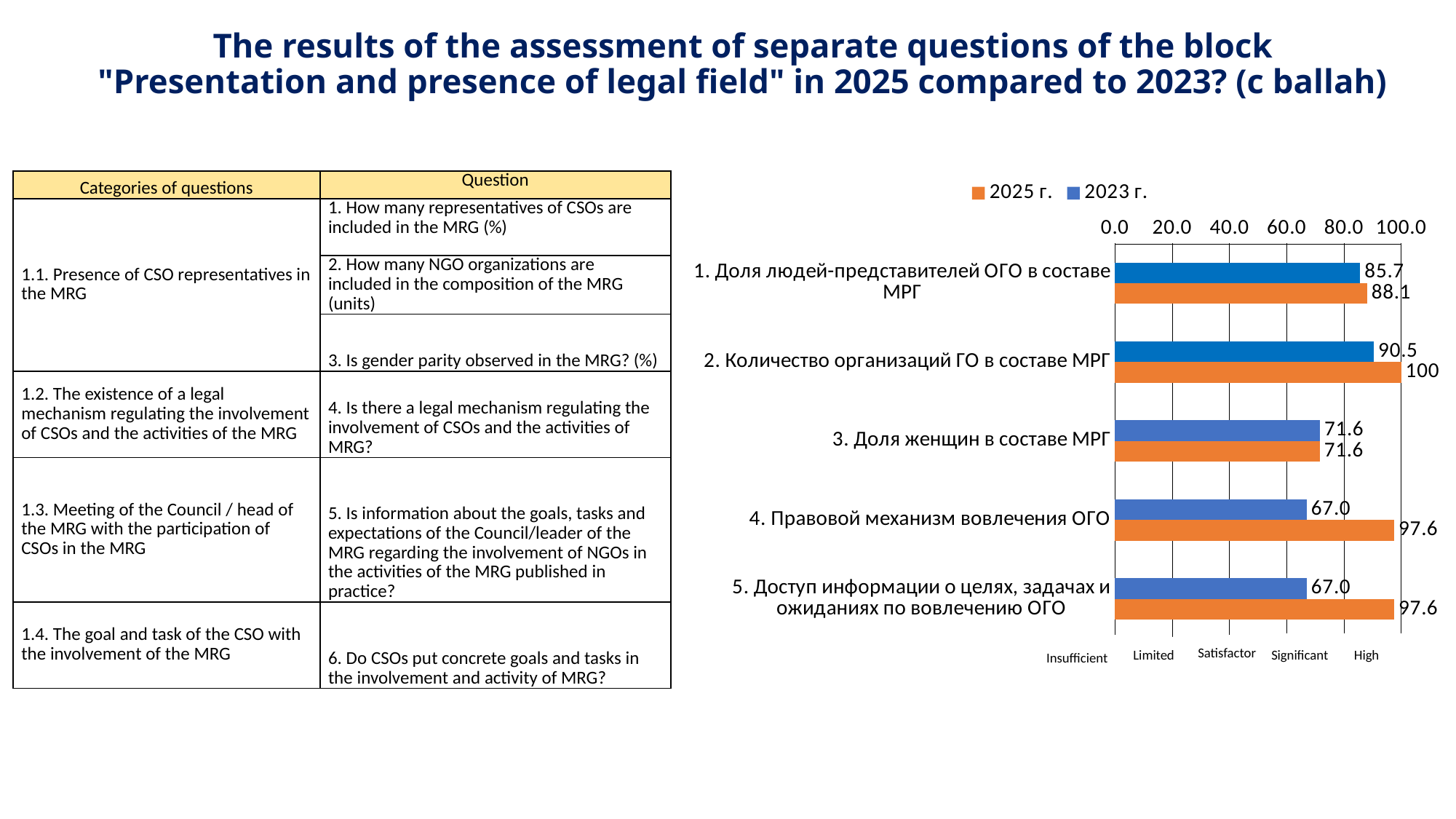
Which category has the highest 2025 г. value? 2. Количество организаций ГО в составе МРГ How many series does the chart legend list? 2 Which is larger for "1. Доля людей-представителей ОГО в составе МРГ": the 2025 г. value or the 2023 г. value? 2025 г. What is the 2023 г. value for "3. Доля женщин в составе МРГ"? 71.6 What type of chart is shown on the slide? bar chart How many categories are plotted in the chart? 5 What is the 2023 г. value for "1. Доля людей-представителей ОГО в составе МРГ"? 85.7 What is the difference between the 2025 г. and 2023 г. values for "4. Правовой механизм вовлечения ОГО"? 30.6 What is the 2025 г. value for "2. Количество организаций ГО в составе МРГ"? 100 What is the 2025 г. value for "4. Правовой механизм вовлечения ОГО"? 97.6 Which colour represents the 2023 г. series in the chart? blue Which category has the lowest 2025 г. value? 3. Доля женщин в составе МРГ